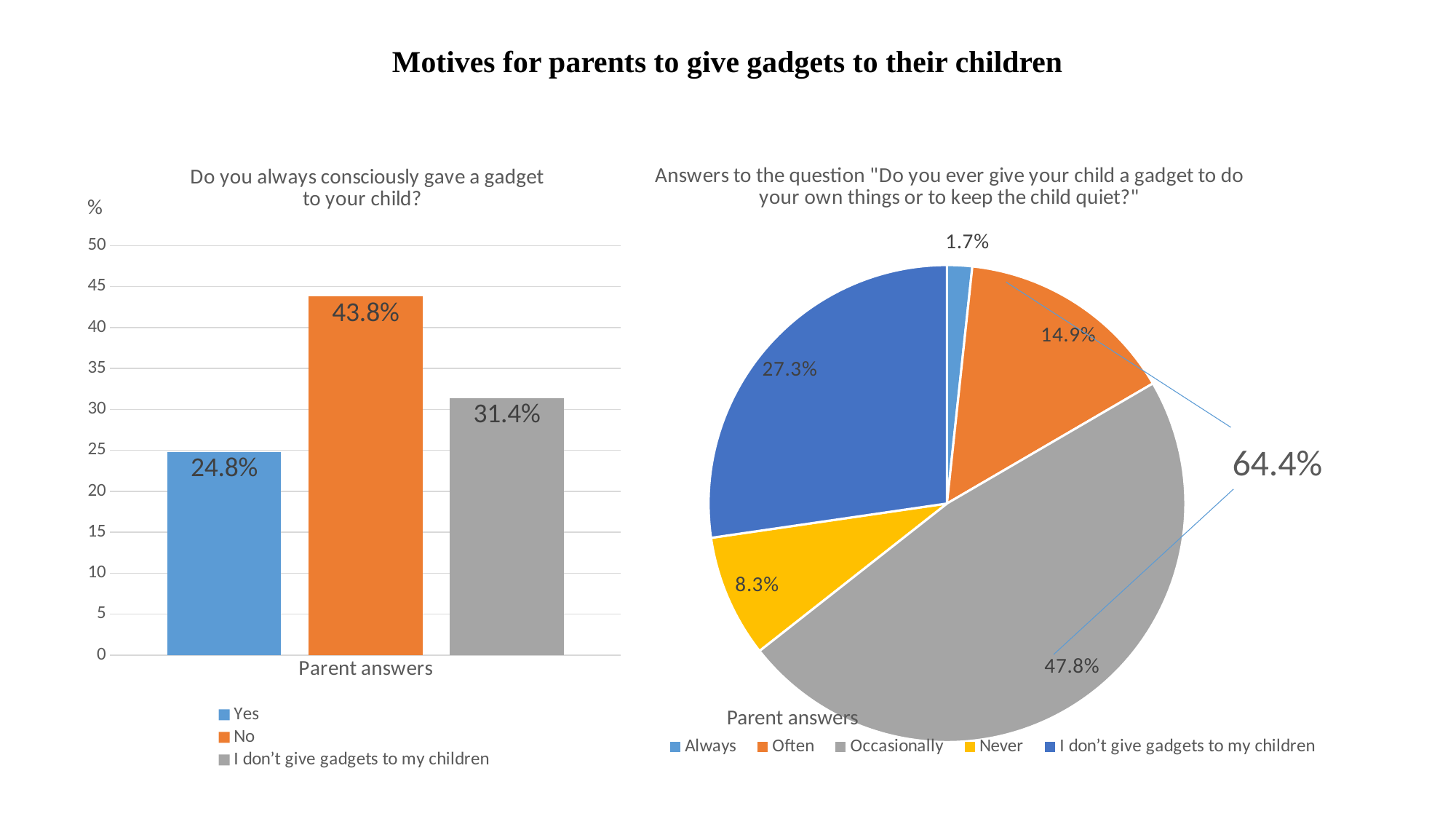
How many entries does the legend of the right pie chart list? 5 In the left bar chart, what is the difference between the values for "No" and "Yes"? 19.0% In the left bar chart, which answer has the highest value? No In the right pie chart, which answer has the smallest slice? Always In the left chart "Do you always consciously gave a gadget to your child?", what is the value for "No"? 43.8% In the left bar chart, is the value for "I don't give gadgets to my children" greater or less than 30? greater In the left bar chart, which answer has the lowest value? Yes In the right pie chart, what share of parent answers is "Occasionally"? 47.8% In the right pie chart, what is the value for "Never"? 8.3% In the right pie chart, which is larger: "Often" or "I don't give gadgets to my children"? I don't give gadgets to my children What kind of chart is the left chart on the slide? Bar chart In the left chart "Do you always consciously gave a gadget to your child?", what is the value for "Yes"? 24.8%